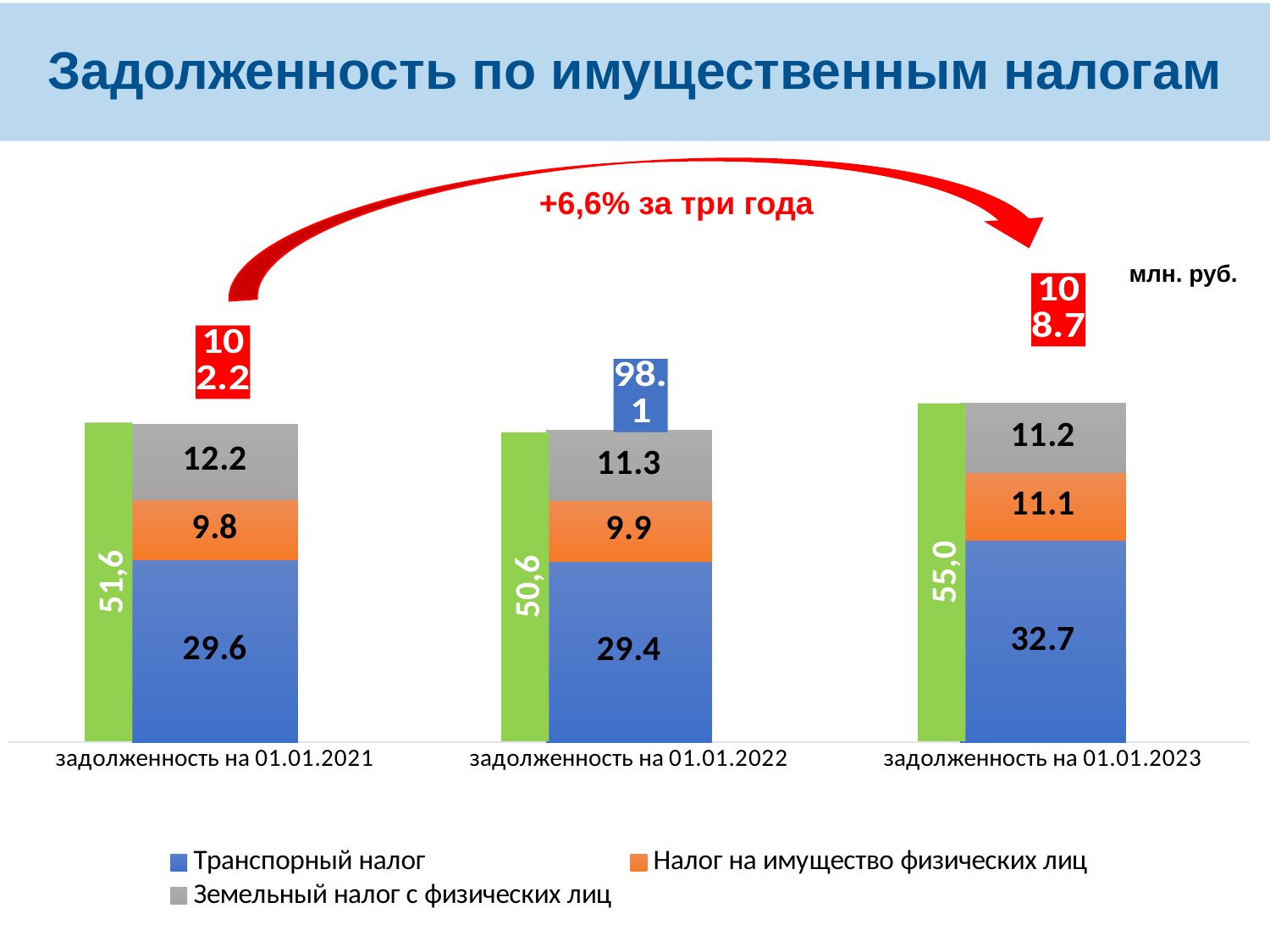
In which category is Транспортный налог the highest? задолженность на 01.01.2023 How many categories are shown along the x axis? 3 How many series does the legend list? 3 Which is larger: Земельный налог с физических лиц for 01.01.2021 or for 01.01.2022? 01.01.2021 What kind of chart is shown on the slide? bar chart What is the difference between Транспортный налог for 01.01.2023 and for 01.01.2021? 3.1 What is the value of Налог на имущество физических лиц for задолженность на 01.01.2022? 9.9 What is the value of Земельный налог с физических лиц for задолженность на 01.01.2021? 12.2 In which category is Транспортный налог the lowest? задолженность на 01.01.2022 What is the value of Транспортный налог for задолженность на 01.01.2023? 32.7 Does Налог на имущество физических лиц rise or fall from 01.01.2021 to 01.01.2023? rises What percentage change over three years is written in red above the chart? +6,6% за три года